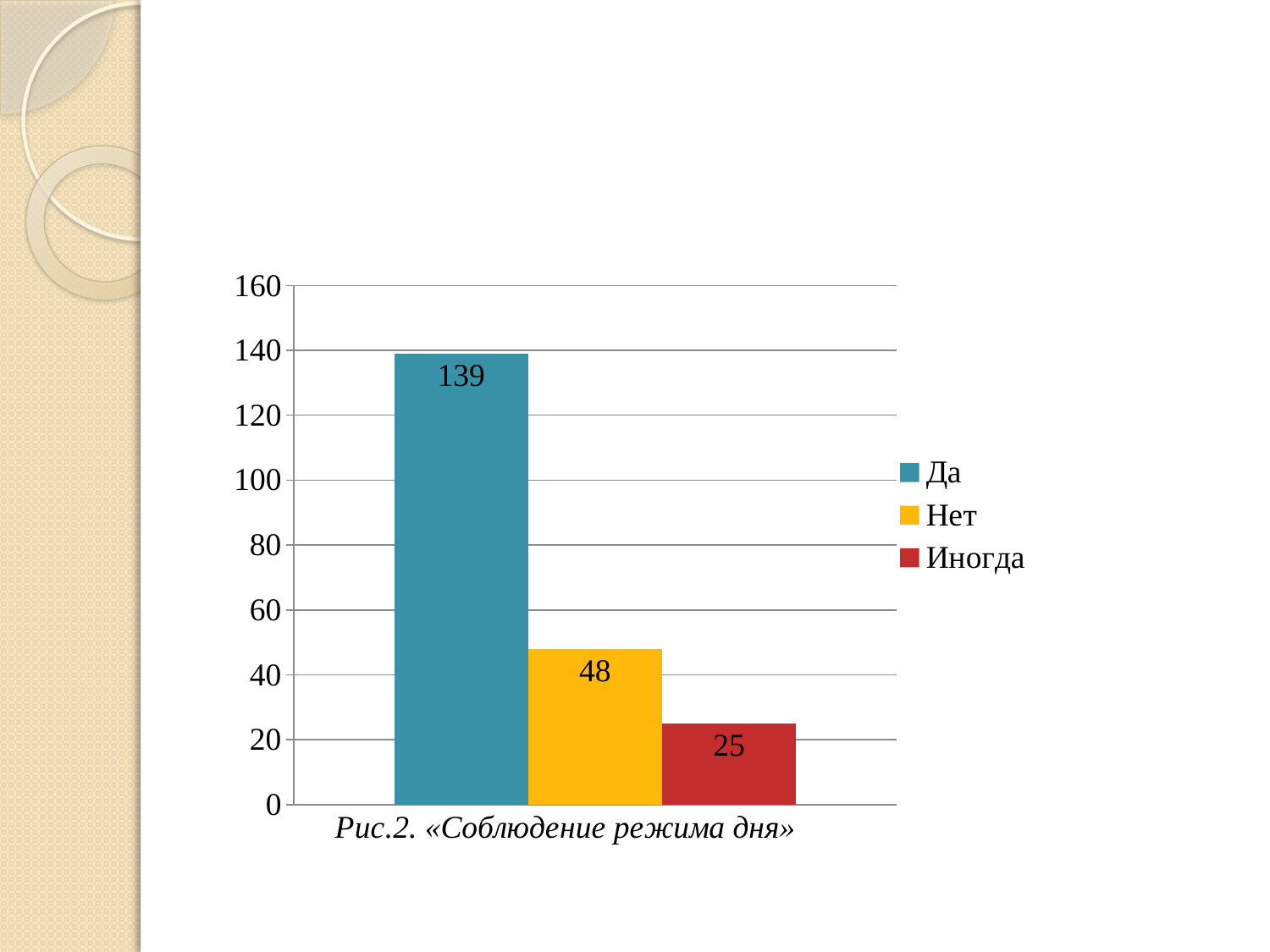
Is the value for Да greater or less than 120? greater How many series does the legend list? 3 What is the caption shown below the chart? Рис.2. «Соблюдение режима дня» What is the difference between the values for Да and Нет? 91 What is the difference between the values for Нет and Иногда? 23 Which is larger, the value for Нет or the value for Иногда? Нет What is the value for Иногда? 25 Which series has the lowest value? Иногда What kind of chart is shown on the slide? bar chart Which series has the highest value? Да What is the value for Да? 139 What is the value for Нет? 48